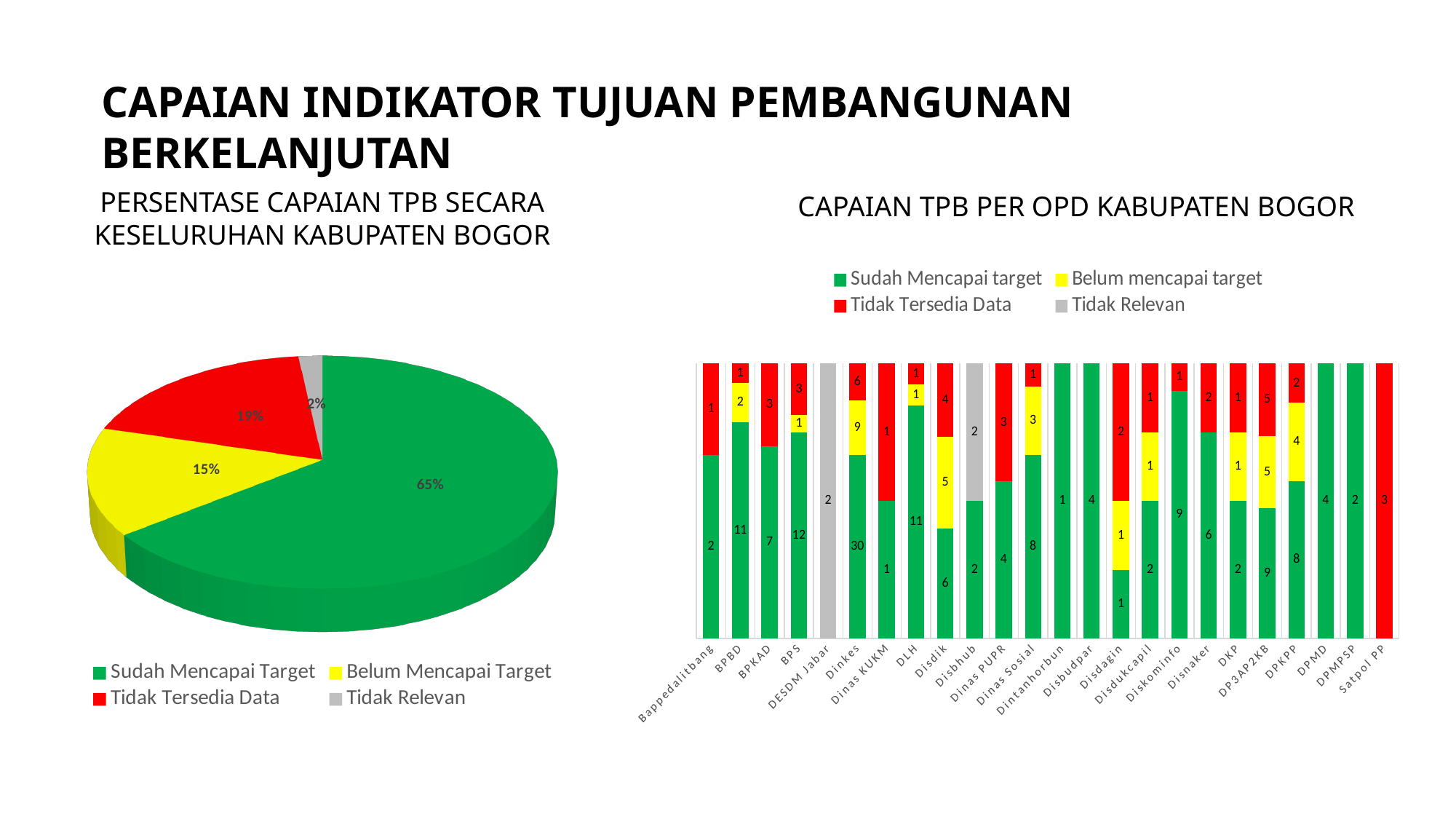
In the chart titled CAPAIAN TPB PER OPD KABUPATEN BOGOR, what is the Sudah Mencapai target value for Dinkes? 30 In the chart titled CAPAIAN TPB PER OPD KABUPATEN BOGOR, what is the total of the labelled values in the Dinkes bar? 45 In the chart titled CAPAIAN TPB PER OPD KABUPATEN BOGOR, what is the Belum mencapai target value for DP3AP2KB? 5 In the pie chart on the left, what percentage is shown for Sudah Mencapai Target? 65% In the chart titled CAPAIAN TPB PER OPD KABUPATEN BOGOR, which has the larger Sudah Mencapai target value, BPBD or BPKAD? BPBD In the chart titled CAPAIAN TPB PER OPD KABUPATEN BOGOR, what is the Tidak Tersedia Data value for Satpol PP? 3 In the pie chart on the left, what is the difference in percentage points between Tidak Tersedia Data and Belum Mencapai Target? 4 In the pie chart on the left, which category has the smallest slice? Tidak Relevan In the chart titled CAPAIAN TPB PER OPD KABUPATEN BOGOR, how many series does the legend list? 4 What kind of chart is the one on the left of the slide? Pie chart In the pie chart on the left, what percentage is shown for Tidak Tersedia Data? 19% In the chart titled CAPAIAN TPB PER OPD KABUPATEN BOGOR, which OPD has the highest Sudah Mencapai target value? Dinkes